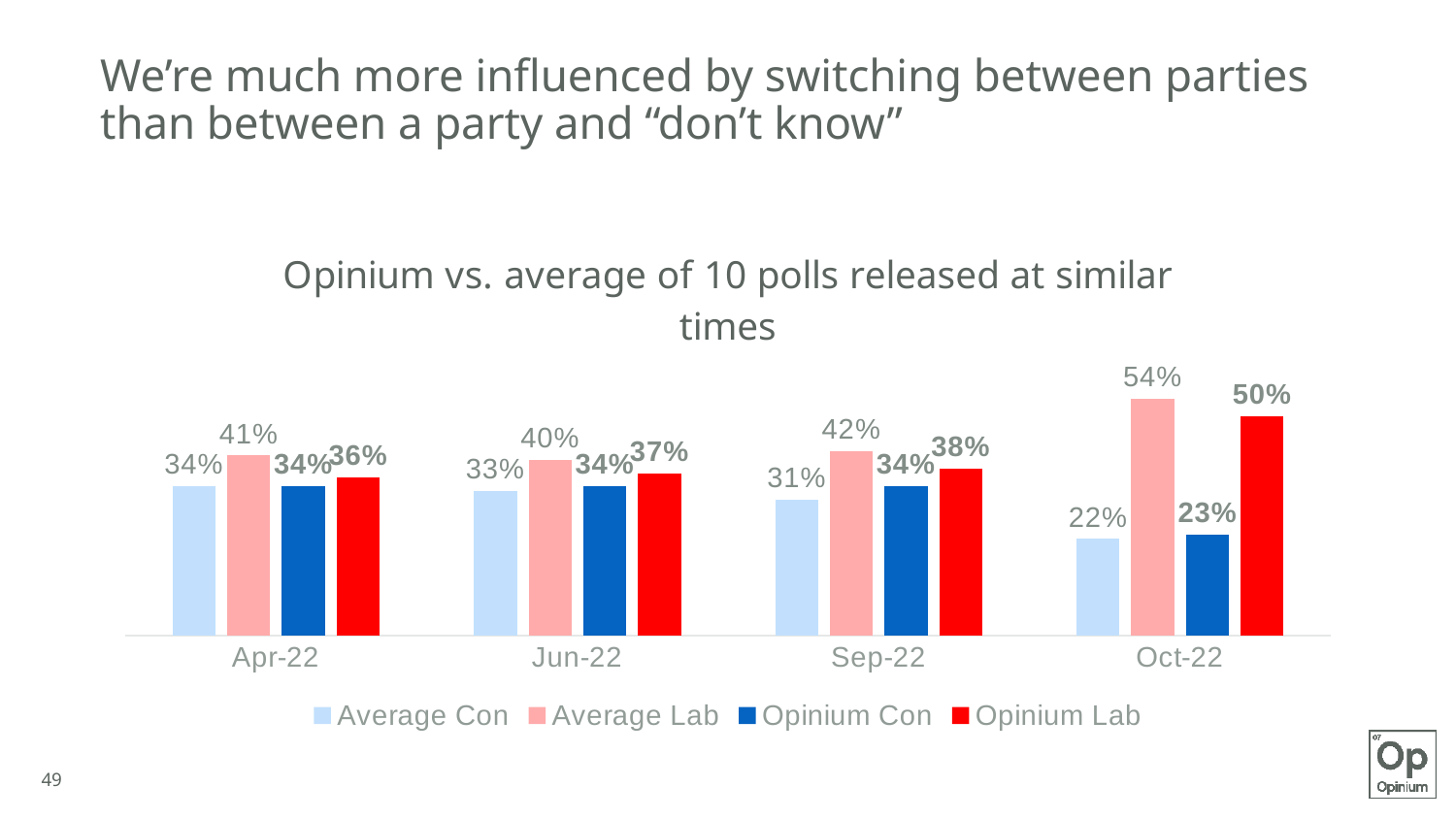
In which period is the Average Lab value highest? Oct-22 Which is larger in Jun-22, Average Lab or Opinium Lab? Average Lab What is the value for Opinium Lab in Apr-22? 36% In which period is the Average Con value lowest? Oct-22 What is the difference between Average Lab and Average Con in Sep-22? 11% How many periods are shown on the x axis? 4 What kind of chart is shown on the slide? Bar chart What is the value for Opinium Con in Sep-22? 34% How many series does the legend list? 4 What is the difference between Average Lab and Opinium Lab in Oct-22? 4% What is the value for Average Lab in Oct-22? 54% What is the value for Average Con in Jun-22? 33%